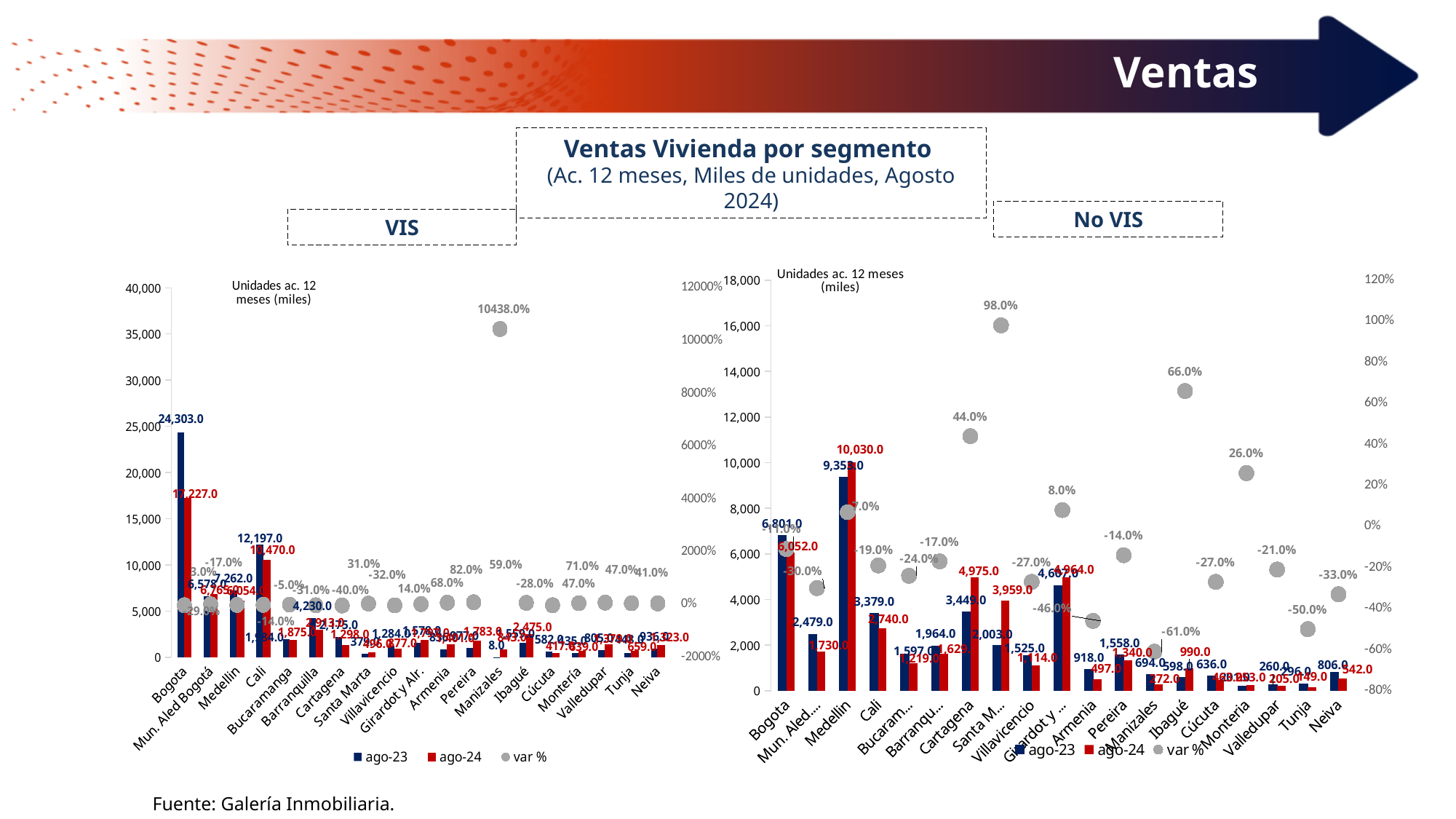
In the VIS chart, what is the ago-23 value for Bogota? 24,303.0 In the No VIS chart, what is the ago-24 value for Cartagena? 4,975.0 In the VIS chart, what is the ago-24 value for Bogota? 17,227.0 In the VIS chart, what is the difference between the ago-23 and ago-24 values for Bogota? 7,076.0 In the No VIS chart, which is larger for Cartagena, the ago-23 value or the ago-24 value? ago-24 In the VIS chart, what is the ago-23 value for Cali? 12,197.0 In the VIS chart, which city has the highest ago-23 value? Bogota In the No VIS chart, what is the ago-24 value for Medellin? 10,030.0 How many series does the legend of the VIS chart list? 3 In the No VIS chart, what is the var % value for Santa Marta? 98.0% In the No VIS chart, which city has the highest ago-24 value? Medellin In the VIS chart, what is the var % value for Manizales? 10438.0%